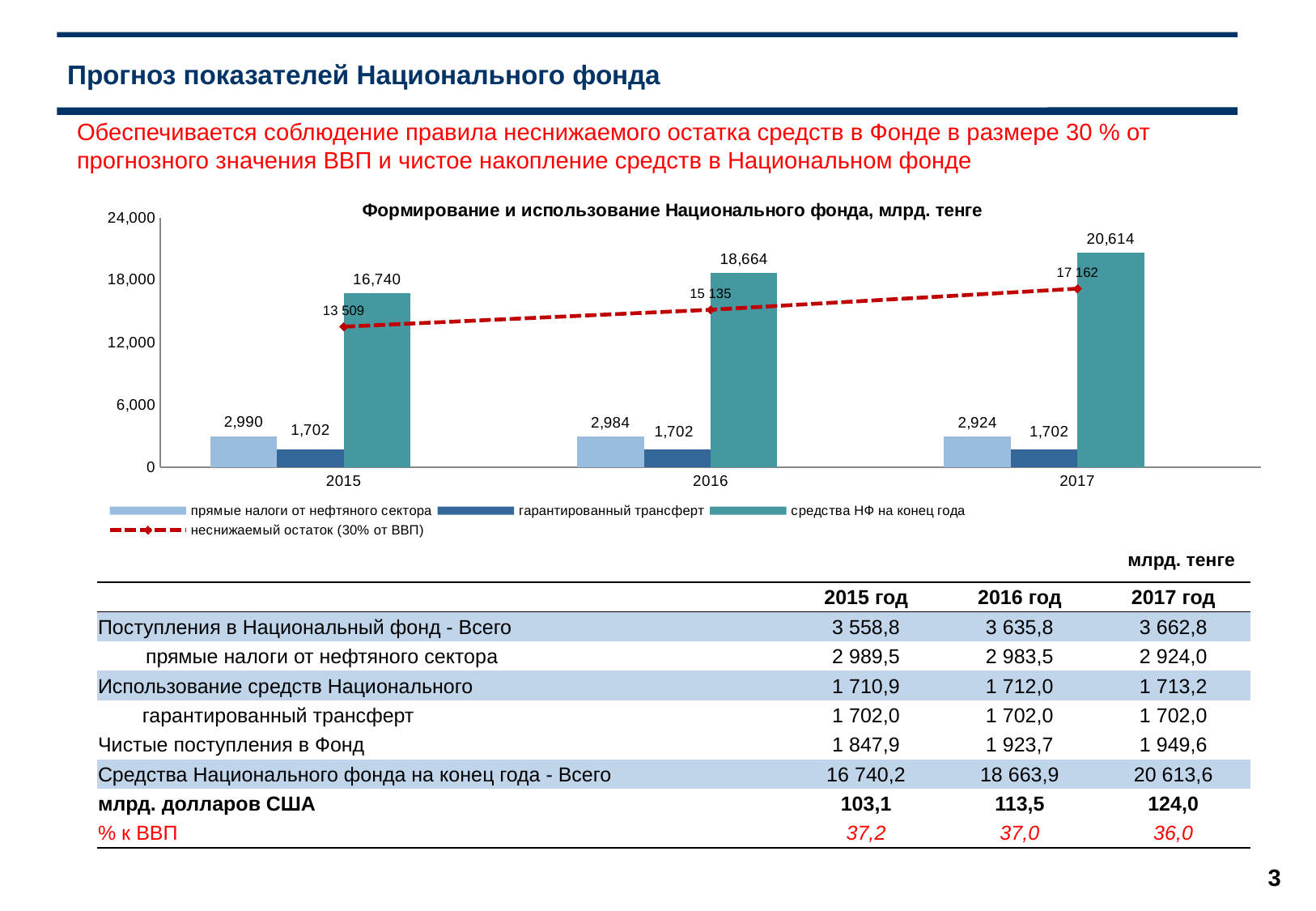
In which year is 'средства НФ на конец года' highest? 2017 What is the value of 'гарантированный трансферт' for 2017? 1,702 What is the value of 'прямые налоги от нефтяного сектора' for 2015 in the chart? 2,990 How many series does the chart legend list? 4 What is the value of the 'неснижаемый остаток (30% от ВВП)' line for 2016? 15 135 In which year is 'прямые налоги от нефтяного сектора' lowest? 2017 What is the value of 'средства НФ на конец года' for 2017 in the chart? 20,614 Does the 'неснижаемый остаток (30% от ВВП)' line rise or fall from 2015 to 2017? Rises What kind of chart is shown on the slide? Bar chart with a line What is the difference between 'средства НФ на конец года' in 2017 and in 2015? 3,874 Which is larger in 2016: 'средства НФ на конец года' or the 'неснижаемый остаток (30% от ВВП)' line? средства НФ на конец года How many years are shown on the x axis of the chart? 3